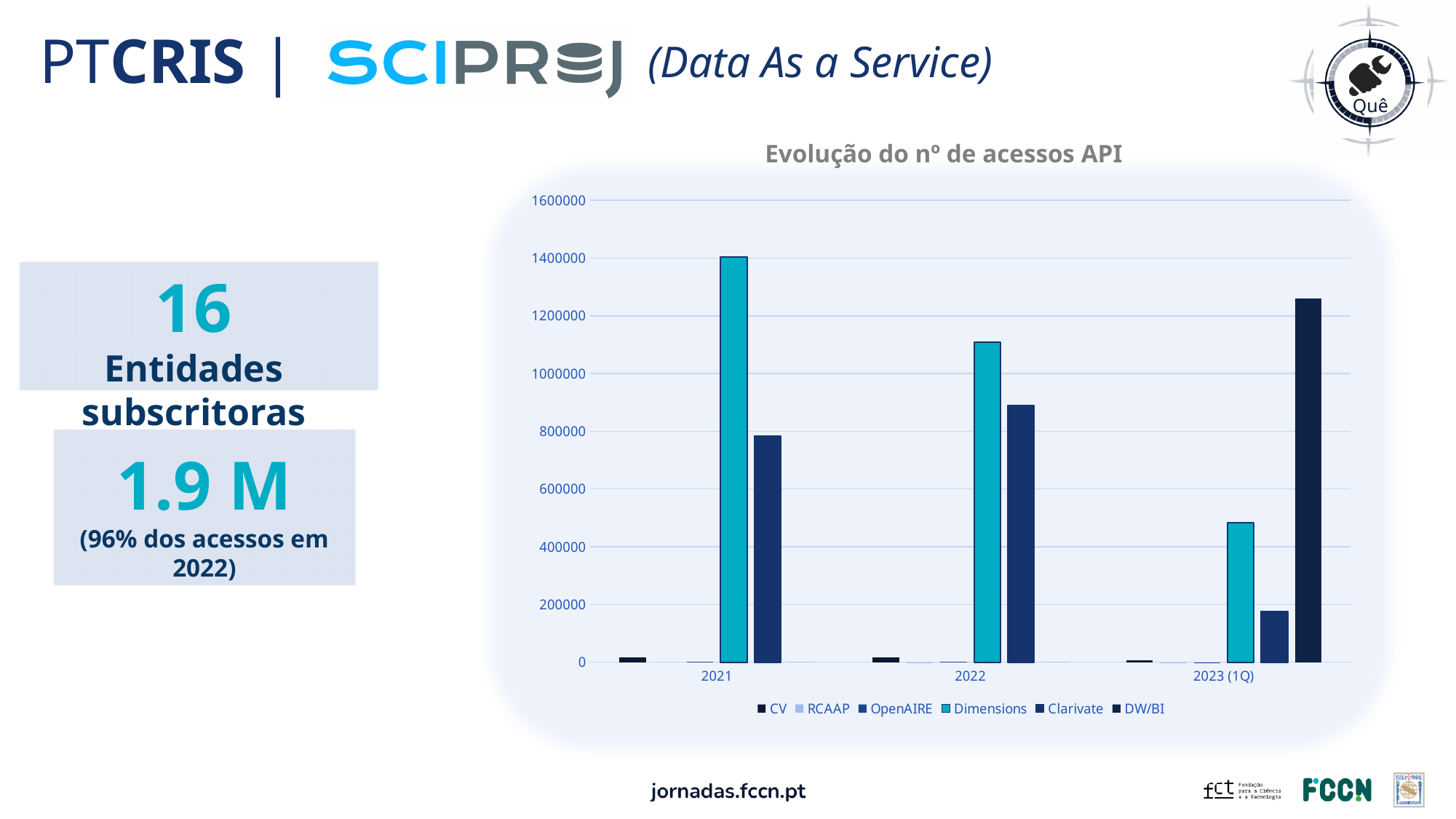
What is the title of the chart? Evolução do nº de acessos API Is the value for Dimensions in 2021 greater or less than 1200000? greater How many series does the chart legend list? 6 What type of chart is shown on the slide? bar chart Is the value for Dimensions in 2023 (1Q) greater or less than 600000? less Is the value for Clarivate in 2021 greater or less than 1000000? less How many categories are shown on the x axis of the chart? 3 Do the Dimensions values rise or fall from 2021 to 2023 (1Q)? fall In which year is the Dimensions bar highest? 2021 In 2023 (1Q), which is larger: the DW/BI bar or the Dimensions bar? DW/BI